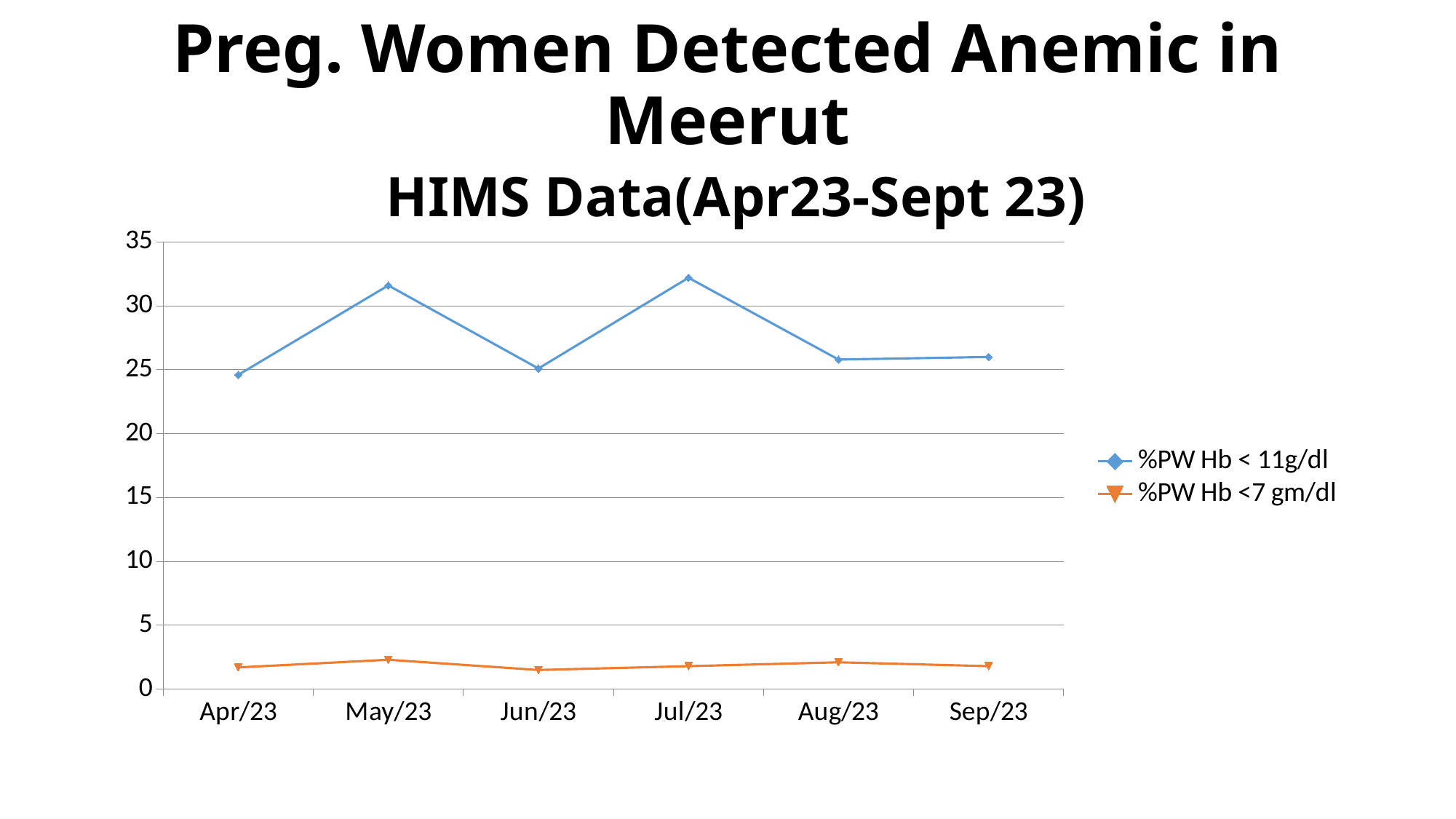
Which is larger for %PW Hb < 11g/dl: May/23 or Jun/23? May/23 What is the subtitle shown above the chart? HIMS Data(Apr23-Sept 23) How many months are plotted along the x axis? 6 Is the value for %PW Hb < 11g/dl in May/23 greater or less than 30? greater What kind of chart is shown on the slide? line chart Does the %PW Hb < 11g/dl line rise or fall from Apr/23 to May/23? rise Is the value for %PW Hb < 11g/dl in Jun/23 greater or less than 30? less In Aug/23, which series has the larger value: %PW Hb < 11g/dl or %PW Hb <7 gm/dl? %PW Hb < 11g/dl How many series does the legend list? 2 Does the %PW Hb < 11g/dl line rise or fall from Jul/23 to Aug/23? fall Is the value for %PW Hb <7 gm/dl in Jul/23 greater or less than 5? less Which month has the highest value for %PW Hb < 11g/dl? Jul/23